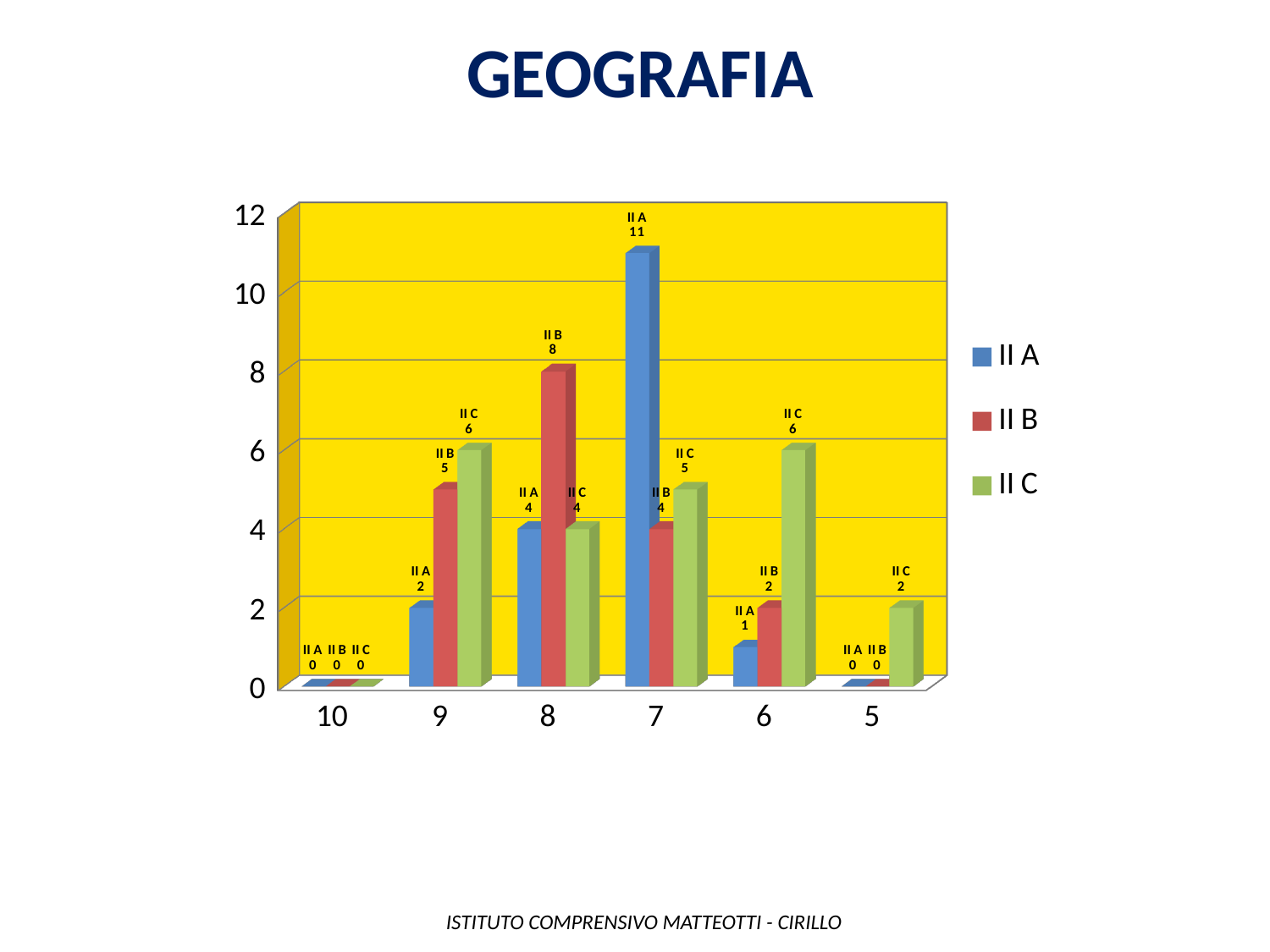
What is the value for II C at category 9? 6 How many categories are shown on the x axis? 6 What is the value for II B at category 8? 8 What is the title of the chart? GEOGRAFIA Which category has the highest value for II B? 8 What is the value for II A at category 6? 1 What kind of chart is shown on the slide? bar chart How many series does the legend list? 3 What is the difference between the II A value and the II B value at category 7? 7 Which category has the highest value for II A? 7 What is the value for II A at category 7? 11 Which is larger at category 6: the value for II B or the value for II C? II C